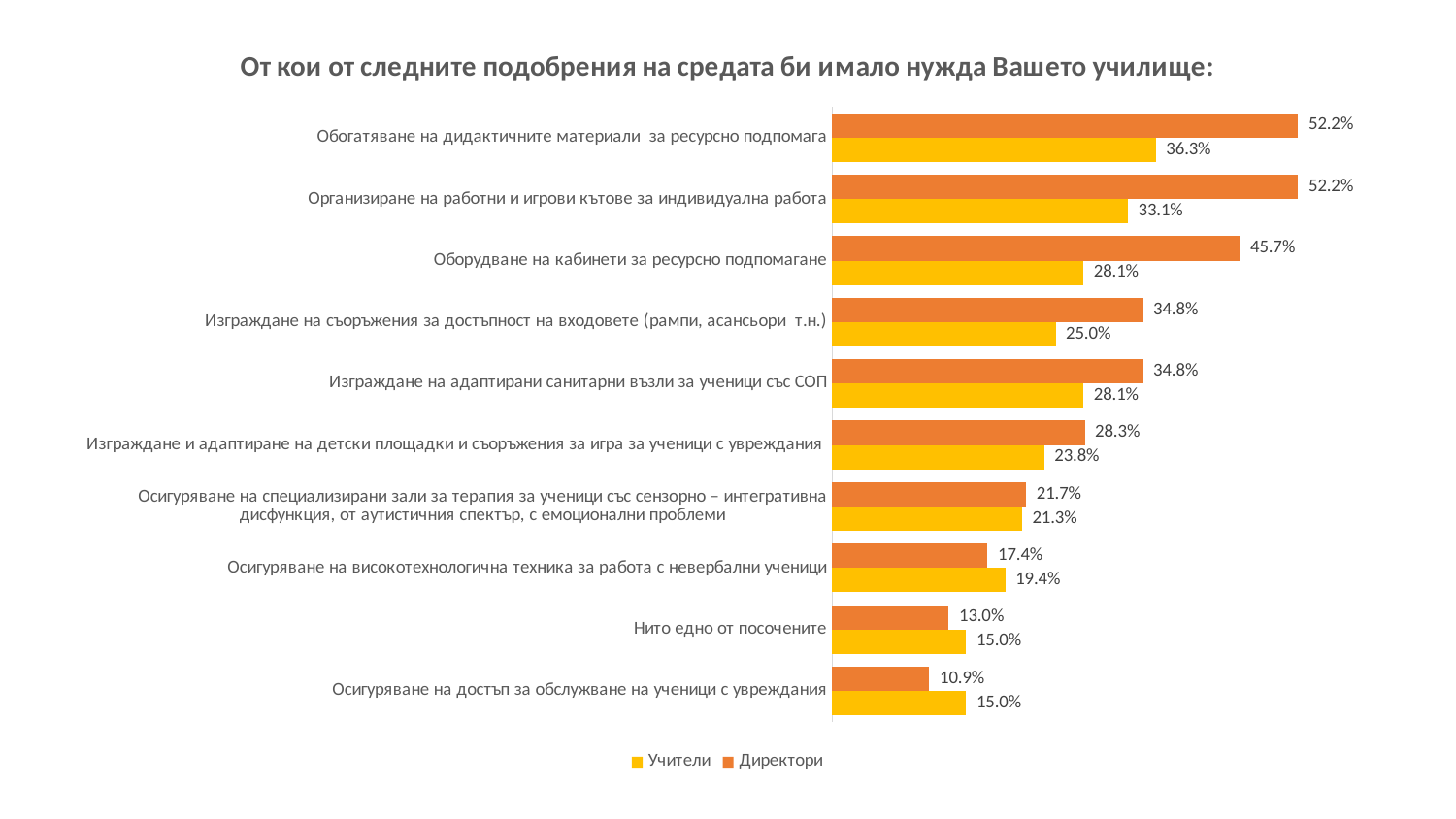
What is the value for Учители for 'Нито едно от посочените'? 15.0% For 'Осигуряване на високотехнологична техника за работа с невербални ученици', which series has the larger value, Учители or Директори? Учители What is the difference between the Директори and Учители values for 'Обогатяване на дидактичните материали за ресурсно подпомага'? 15.9% Which category has the lowest value for Директори? Осигуряване на достъп за обслужване на ученици с увреждания What type of chart is shown on the slide? Bar chart What is the value for Директори for 'Оборудване на кабинети за ресурсно подпомагане'? 45.7% What is the difference between the Директори values for 'Оборудване на кабинети за ресурсно подпомагане' and 'Изграждане на адаптирани санитарни възли за ученици със СОП'? 10.9% How many categories are shown in the chart? 10 How many series does the legend list? 2 Which category has the highest value for Учители? Обогатяване на дидактичните материали за ресурсно подпомага What is the value for Учители for 'Организиране на работни и игрови кътове за индивидуална работа'? 33.1% Which series is shown in orange in the legend? Директори